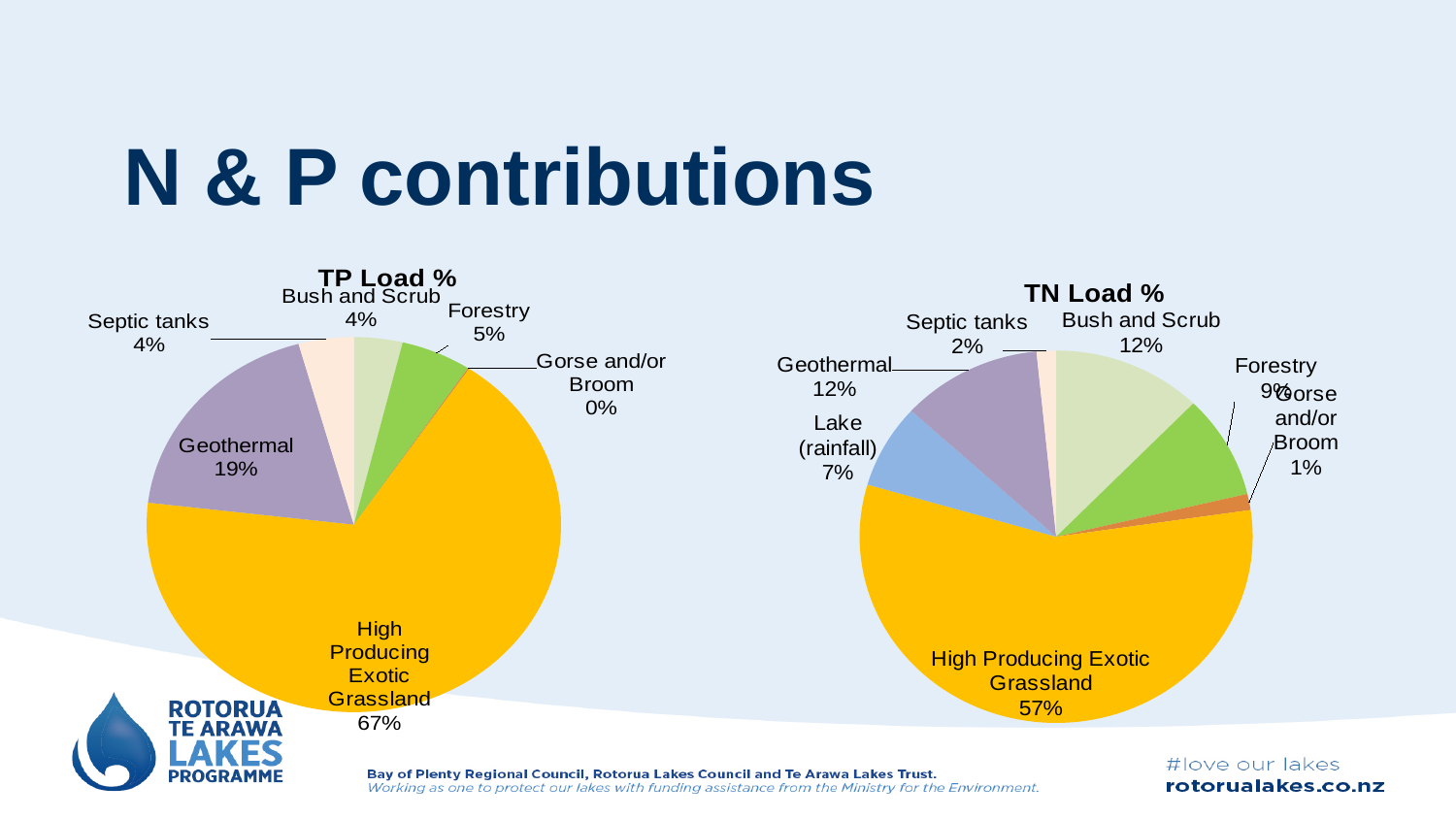
In the TP Load % chart, which category has the largest share? High Producing Exotic Grassland In the TP Load % chart, which category has the smallest share? Gorse and/or Broom What is the difference between the High Producing Exotic Grassland share in the TP Load % chart and in the TN Load % chart? 10% What is the title of the chart on the right of the slide? TN Load % How many categories are shown in the TN Load % chart? 7 In the TN Load % chart, what share does Bush and Scrub have? 12% In the TN Load % chart, what share does Lake (rainfall) have? 7% How many categories are shown in the TP Load % chart? 6 In the TN Load % chart, which category has the smallest share? Gorse and/or Broom In the TN Load % chart, which is larger: Forestry or Septic tanks? Forestry In the TP Load % chart, what share does Geothermal have? 19% What kind of chart is the TP Load % chart? Pie chart